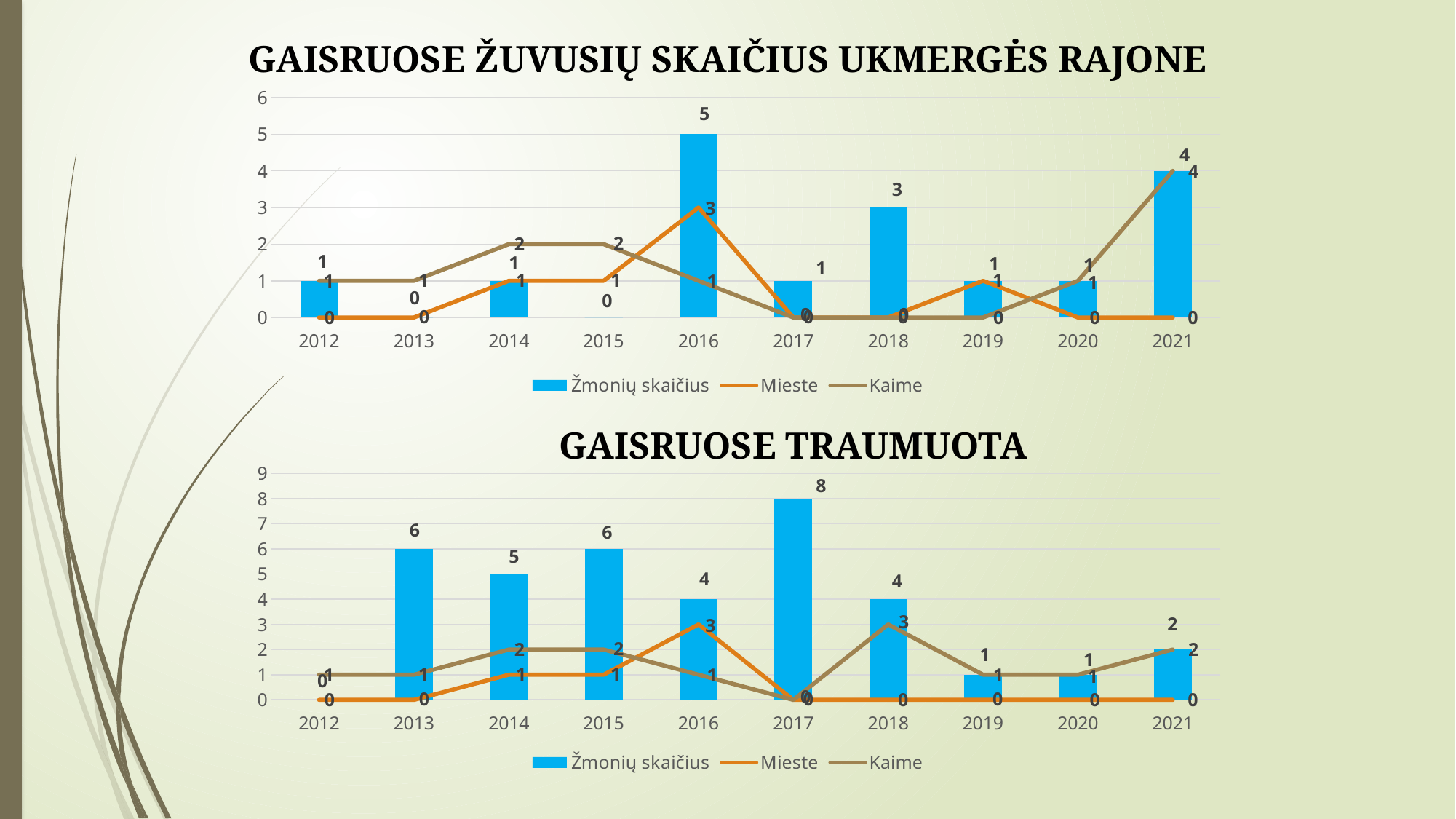
What kind of chart is the chart titled "GAISRUOSE TRAUMUOTA"? A combined bar and line chart In the chart titled "GAISRUOSE TRAUMUOTA", is the Žmonių skaičius value for 2013 larger or smaller than the value for 2014? larger In the chart titled "GAISRUOSE ŽUVUSIŲ SKAIČIUS UKMERGĖS RAJONE", what is the difference between the Žmonių skaičius values for 2016 and 2018? 2 In the chart titled "GAISRUOSE ŽUVUSIŲ SKAIČIUS UKMERGĖS RAJONE", which year has the highest Žmonių skaičius bar? 2016 In the chart titled "GAISRUOSE ŽUVUSIŲ SKAIČIUS UKMERGĖS RAJONE", how many series does the legend list? 3 In the chart titled "GAISRUOSE TRAUMUOTA", which year has the lowest Žmonių skaičius bar? 2012 In the chart titled "GAISRUOSE TRAUMUOTA", what is the value of Žmonių skaičius for 2017? 8 In the chart titled "GAISRUOSE TRAUMUOTA", what is the Kaime value for 2018? 3 In the chart titled "GAISRUOSE TRAUMUOTA", what is the Mieste value for 2016? 3 In the chart titled "GAISRUOSE TRAUMUOTA", how many years are shown on the x axis? 10 In the chart titled "GAISRUOSE ŽUVUSIŲ SKAIČIUS UKMERGĖS RAJONE", what is the value of Žmonių skaičius for 2016? 5 In the chart titled "GAISRUOSE ŽUVUSIŲ SKAIČIUS UKMERGĖS RAJONE", what is the Kaime value for 2021? 4